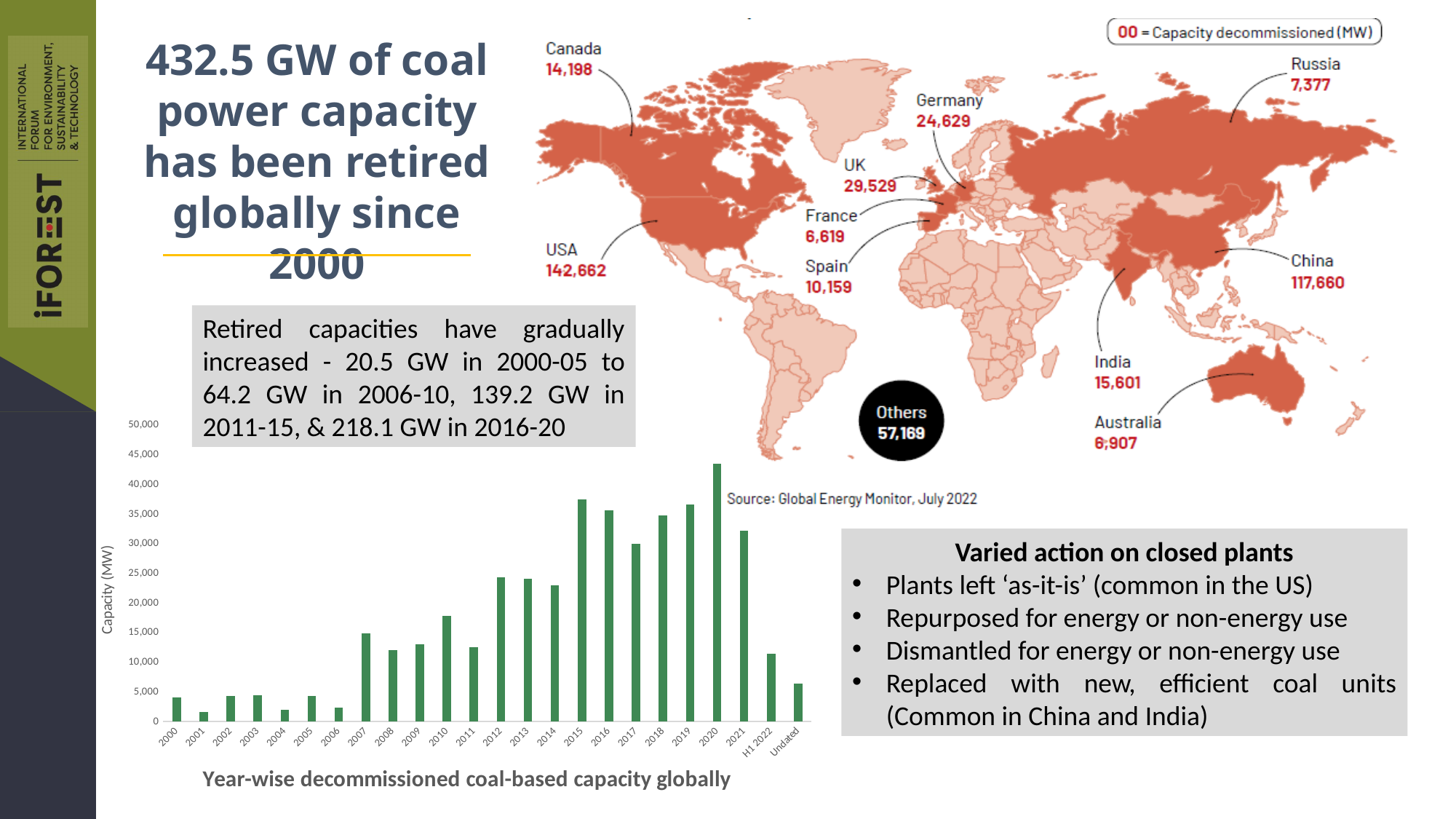
In the 'Year-wise decommissioned coal-based capacity globally' chart, do the values generally rise or fall from 2000 to 2020? rise In the 'Year-wise decommissioned coal-based capacity globally' chart, is the value for 2020 greater or less than 40,000? greater In the 'Year-wise decommissioned coal-based capacity globally' chart, which year has the highest decommissioned capacity? 2020 In the 'Year-wise decommissioned coal-based capacity globally' chart, how many bars (categories) are plotted? 24 In the 'Year-wise decommissioned coal-based capacity globally' chart, which is larger, the value for 2017 or the value for 2018? 2018 In the 'Year-wise decommissioned coal-based capacity globally' chart, is the value for 2010 greater or less than 15,000? greater In the 'Year-wise decommissioned coal-based capacity globally' chart, which is larger, the value for 2019 or the value for 2020? 2020 On the world map, what capacity decommissioned (MW) is shown for the USA? 142,662 In the 'Year-wise decommissioned coal-based capacity globally' chart, is the value for 2000 greater or less than 5,000? less What is the label on the vertical axis of the 'Year-wise decommissioned coal-based capacity globally' chart? Capacity (MW) What kind of chart is the 'Year-wise decommissioned coal-based capacity globally' chart? bar chart